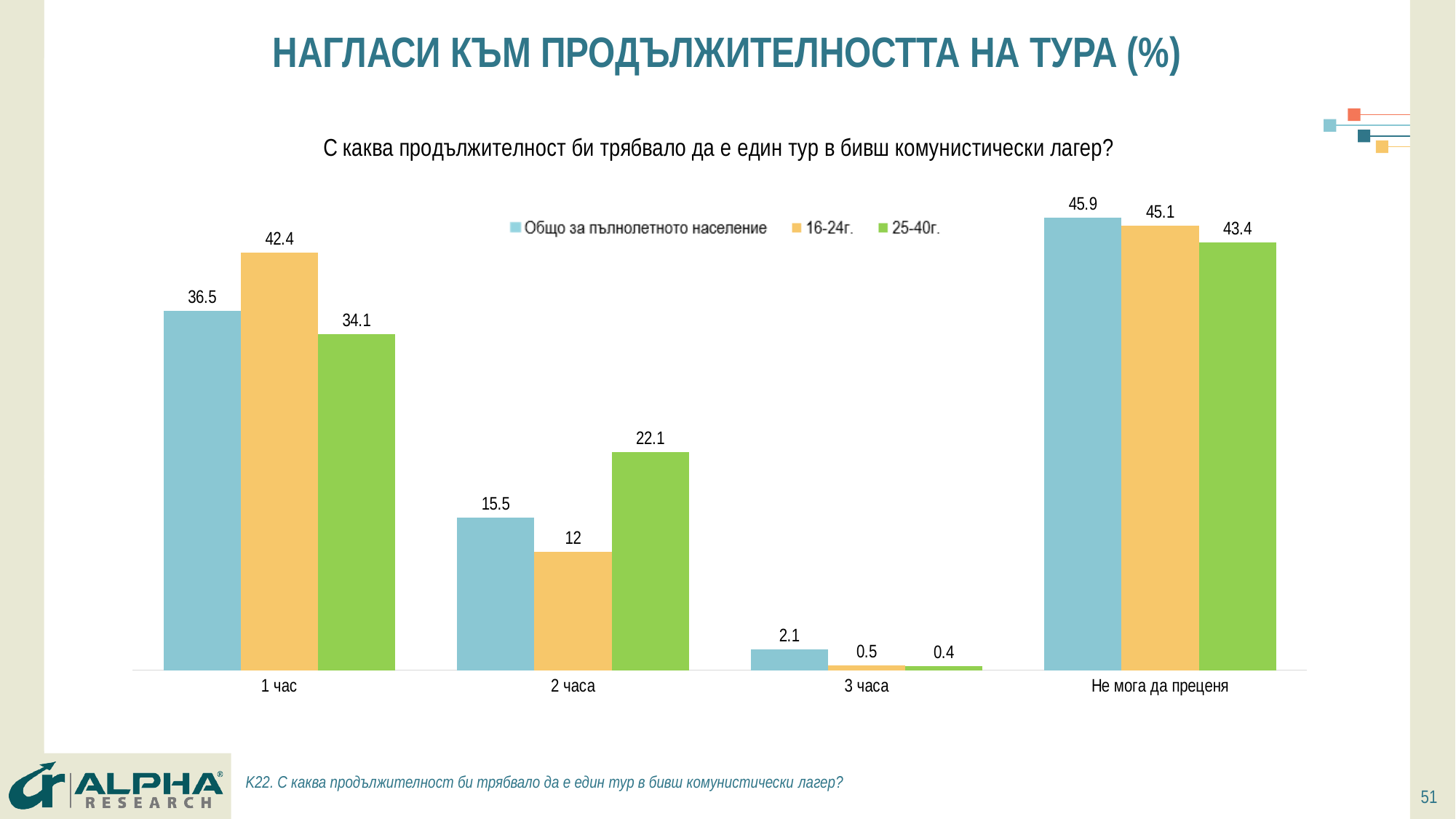
What is the value for the 16-24г. series in the "1 час" category? 42.4 How many categories are shown on the x axis? 4 What is the difference between the 16-24г. and 25-40г. values in the "1 час" category? 8.3 What is the title of the chart on the slide? С каква продължителност би трябвало да е един тур в бивш комунистически лагер? Which category has the lowest value for the "Общо за пълнолетното население" series? 3 часа What type of chart is shown on the slide? Bar chart What is the value for the 25-40г. series in the "2 часа" category? 22.1 What is the value for the 16-24г. series in the "3 часа" category? 0.5 What is the value for "Общо за пълнолетното население" in the "Не мога да преценя" category? 45.9 How many series does the legend list? 3 In the "2 часа" category, which is larger: the value for 16-24г. or for 25-40г.? 25-40г. Which category has the highest value for the 25-40г. series? Не мога да преценя